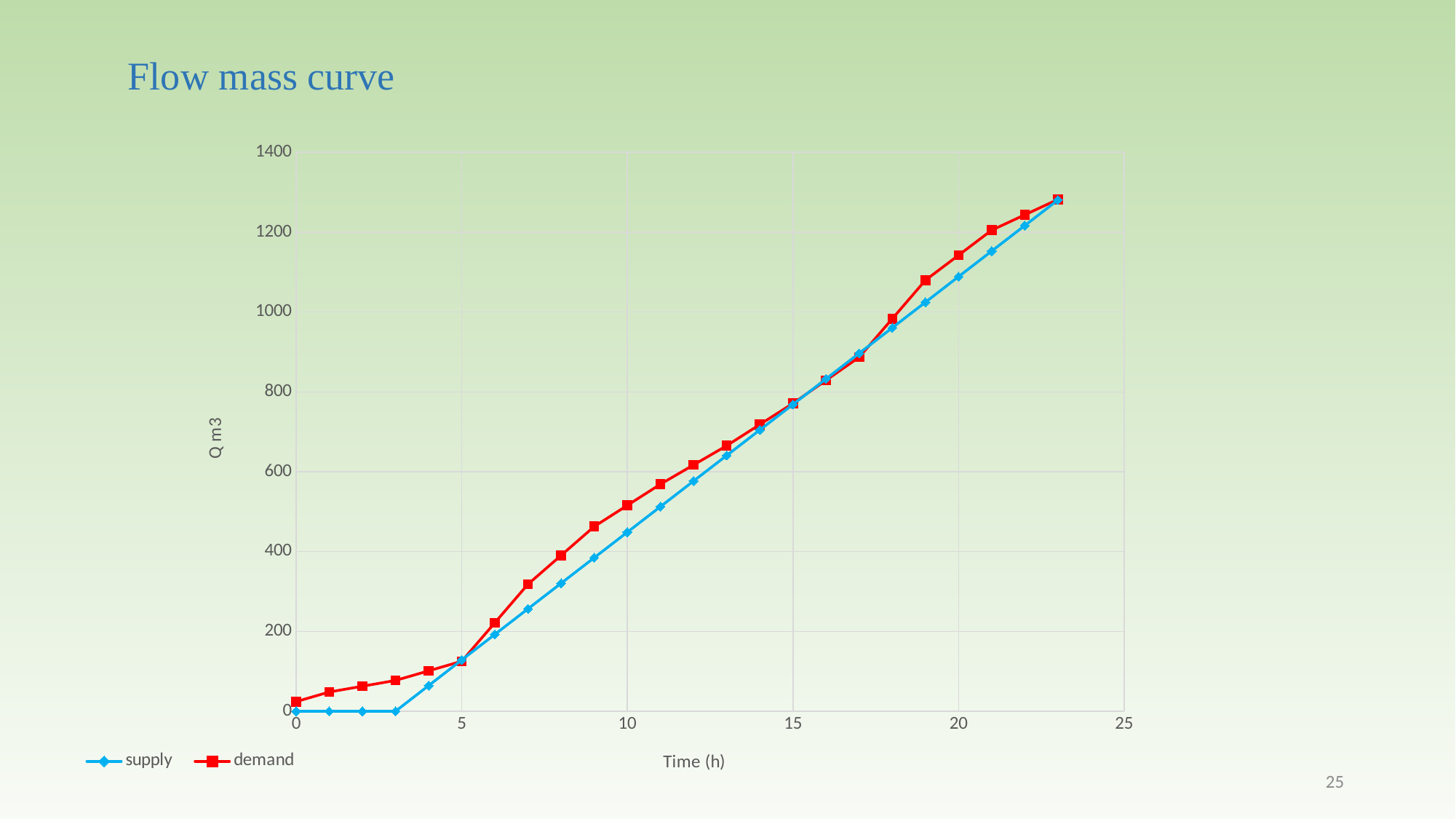
How many data points does the supply series have? 24 What is the title of the chart? Flow mass curve Is the supply value at time 5 greater or less than 200? less At time 8, which series has the higher value, supply or demand? demand Does the supply series rise or fall as time increases from 5 to 23? rise How many series does the legend list? 2 What type of chart is shown on the slide? line chart Is the supply value at time 10 greater or less than 400? greater Is the demand value at time 20 greater or less than 1000? greater What is the supply value at time 0? 0 What is the label of the x axis? Time (h)